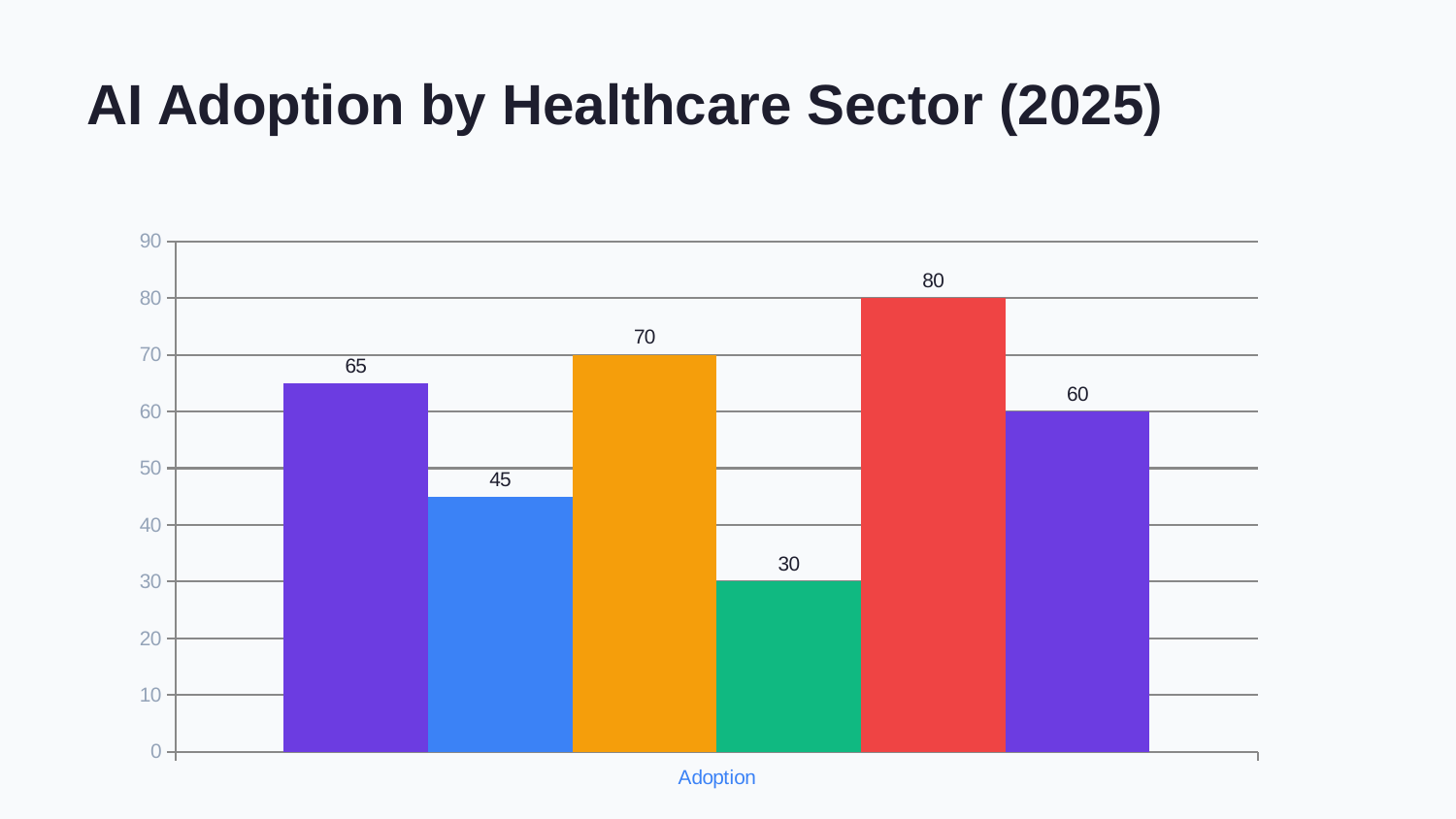
What is the value of the blue bar, second from the left? 45 What is the difference between the red bar and the green bar? 50 How many bars are plotted in the chart? 6 What is the value of the first (leftmost) bar? 65 What is the highest value shown in the chart? 80 What is the value of the green bar? 30 What is the value of the last (rightmost) bar? 60 Which is larger, the orange bar or the first purple bar on the left? The orange bar What is the lowest value shown in the chart? 30 What is the value of the red bar? 80 What type of chart is shown on the slide? Bar chart What is the value of the orange bar? 70